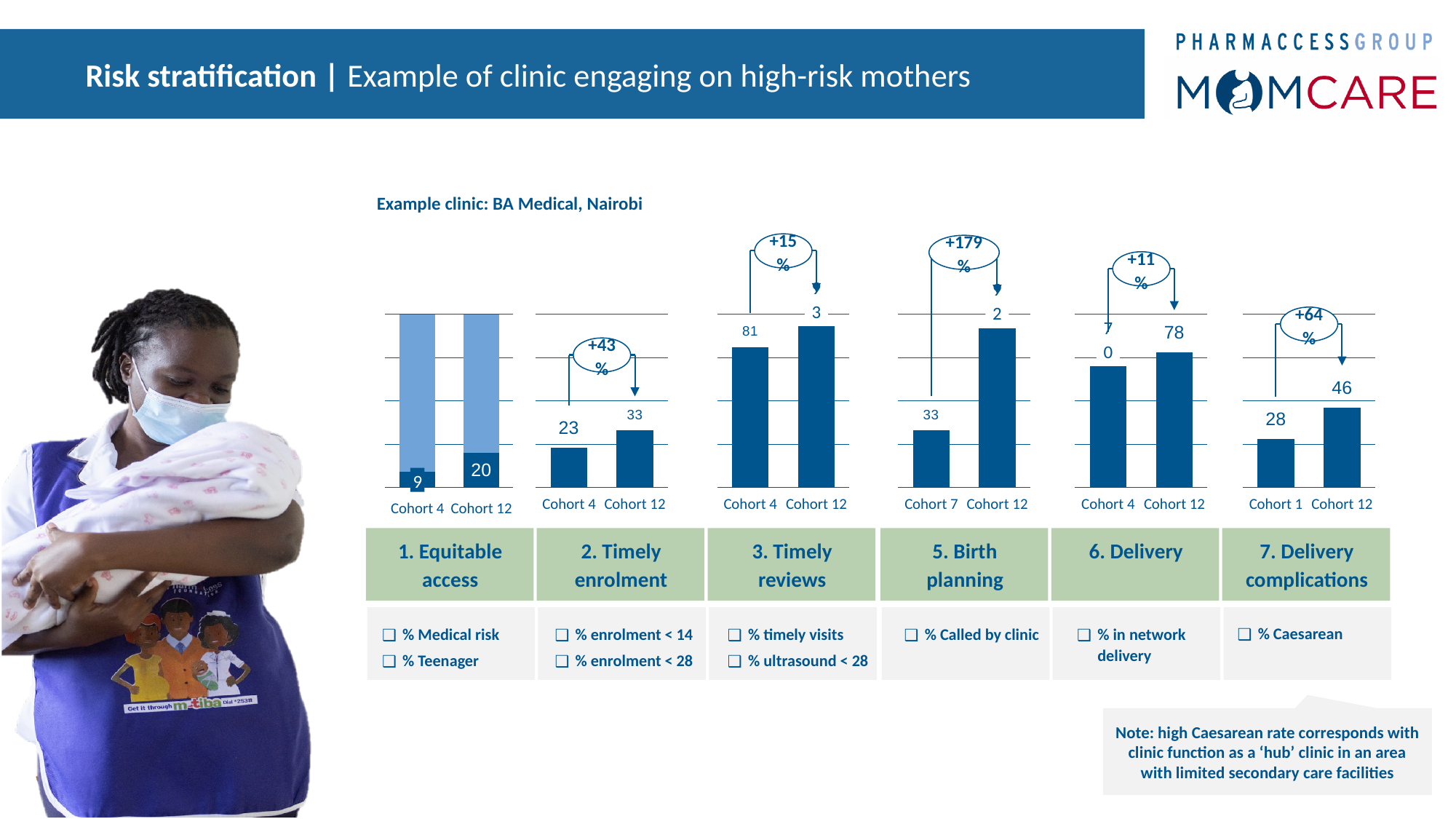
In the '2. Timely enrolment' chart, what is the value for Cohort 4? 23 In the '7. Delivery complications' chart, which cohort has the higher value, Cohort 1 or Cohort 12? Cohort 12 In the '2. Timely enrolment' chart, what is the difference between the Cohort 12 and Cohort 4 values? 10 In the '6. Delivery' chart, what is the value for Cohort 12? 78 What type of chart is used for '2. Timely enrolment'? Bar chart In the '7. Delivery complications' chart, what is the value for Cohort 12? 46 In the '7. Delivery complications' chart, what is the value for Cohort 1? 28 In the '7. Delivery complications' chart, by how much does the Cohort 12 value exceed the Cohort 1 value? 18 In the '5. Birth planning' chart, what is the value for Cohort 7? 33 In the '3. Timely reviews' chart, what is the value for Cohort 4? 81 In the '2. Timely enrolment' chart, what is the value for Cohort 12? 33 In the '1. Equitable access' chart, what value is labelled on the dark segment of the Cohort 12 bar? 20